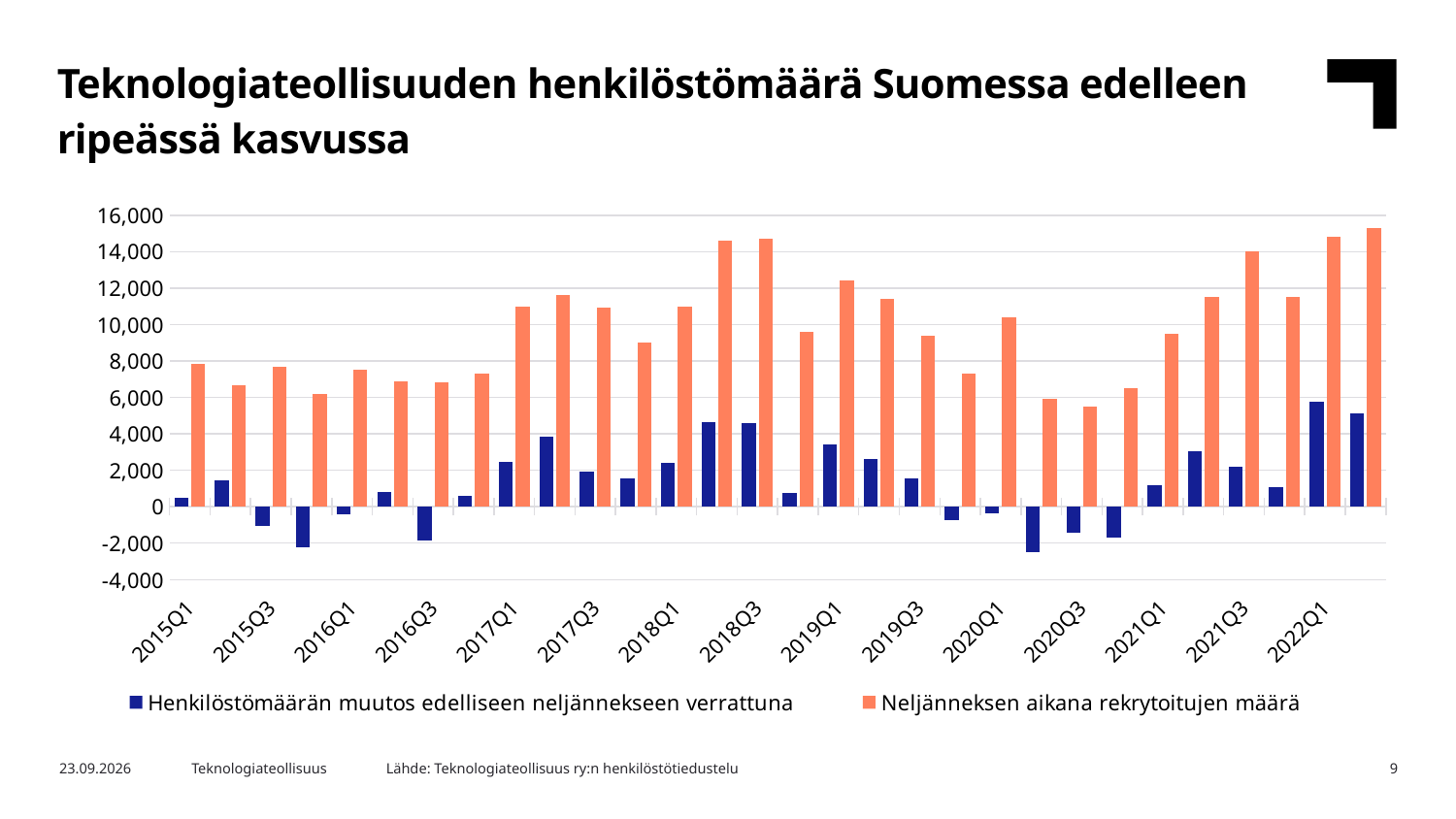
Is the value of 'Henkilöstömäärän muutos edelliseen neljännekseen verrattuna' for 2020Q3 greater or less than 0? less Do the values of 'Neljänneksen aikana rekrytoitujen määrä' rise or fall from 2020Q3 to 2022Q1? rise How many quarters (bar pairs) are plotted on the x axis? 30 Which quarter has the larger value of 'Neljänneksen aikana rekrytoitujen määrä', 2015Q1 or 2018Q3? 2018Q3 Is the value of 'Neljänneksen aikana rekrytoitujen määrä' for 2017Q1 greater or less than 10,000? greater Which quarter has the larger value of 'Henkilöstömäärän muutos edelliseen neljännekseen verrattuna', 2017Q1 or 2022Q1? 2022Q1 Is the value of 'Henkilöstömäärän muutos edelliseen neljännekseen verrattuna' for 2022Q1 greater or less than 4,000? greater What kind of chart is shown on the slide? bar chart How many series does the legend list? 2 Which colour represents 'Neljänneksen aikana rekrytoitujen määrä' in the chart? orange